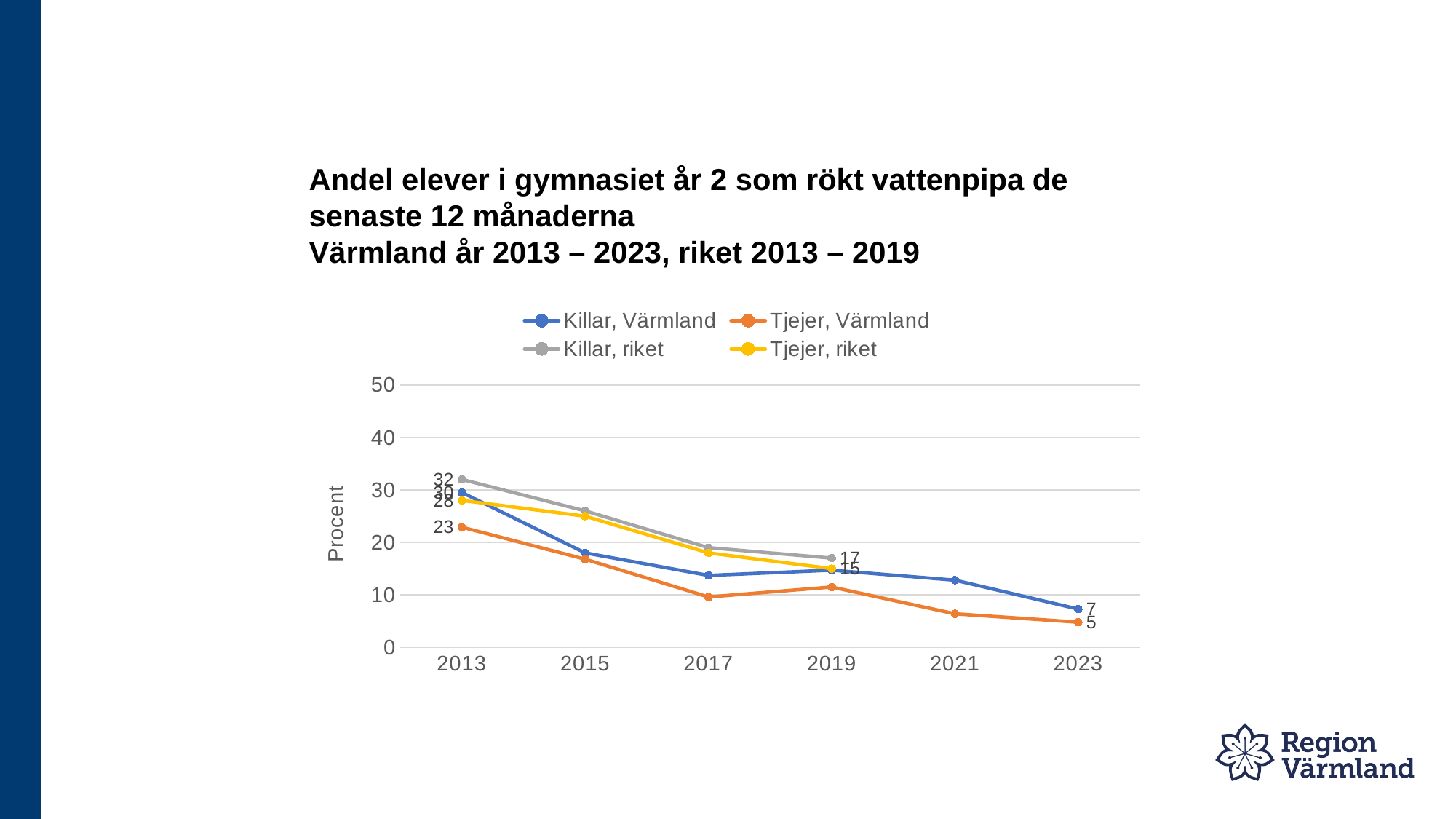
Which series has the highest value in 2013? Killar, riket What is the difference between Killar, riket and Tjejer, riket in 2013? 4 What kind of chart is shown on the slide? line chart What is the value for Tjejer, Värmland in 2013? 23 What is the difference between Killar, Värmland and Tjejer, Värmland in 2023? 2 What is the value for Killar, riket in 2013? 32 What is the value for Tjejer, riket in 2019? 15 Is the value for Killar, Värmland in 2015 greater or less than 20? less What is the label on the y axis? Procent How many series does the legend list? 4 What is the value for Killar, Värmland in 2023? 7 Does the Tjejer, Värmland series rise or fall from 2013 to 2023? fall